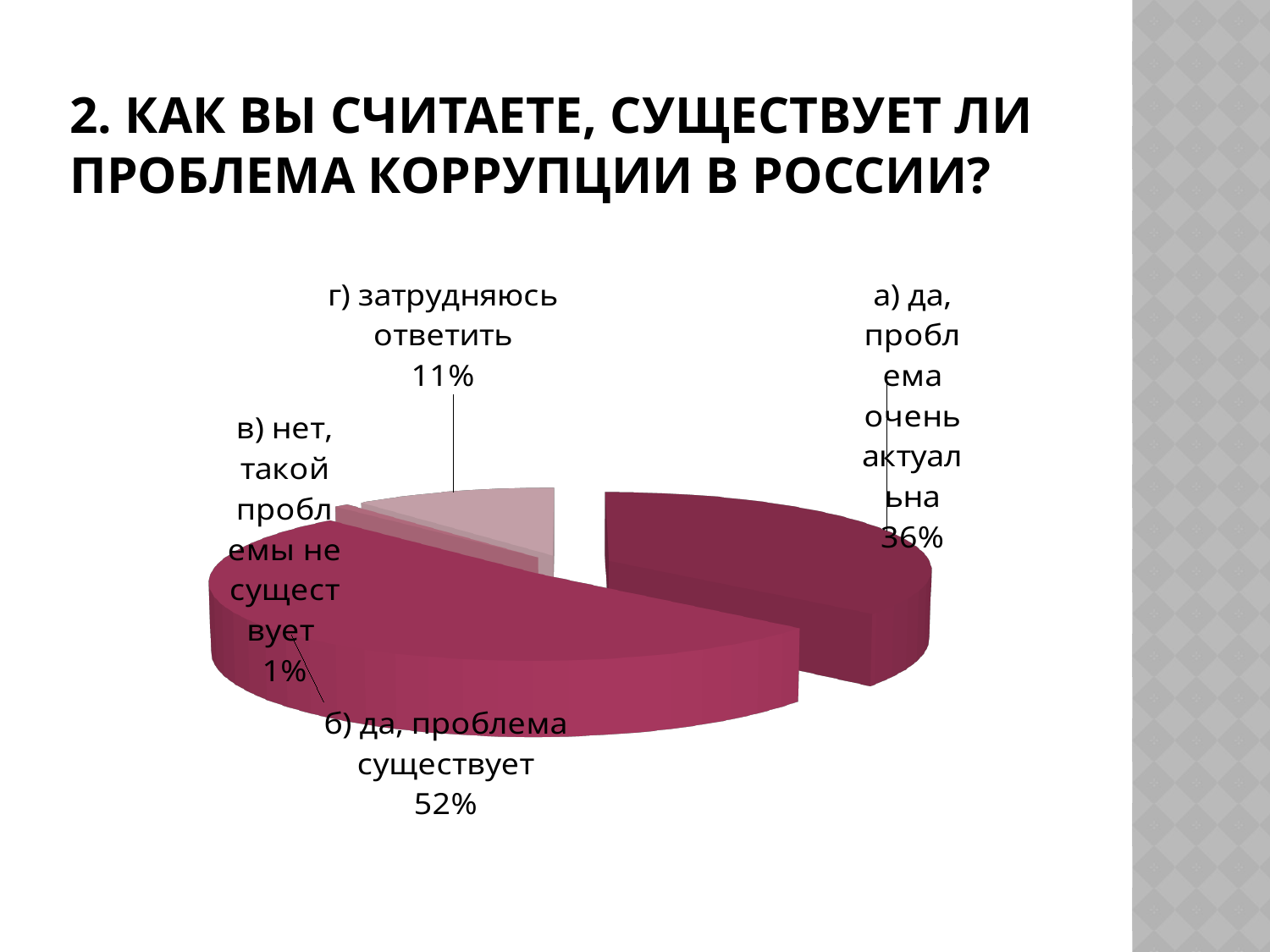
How many slices does the pie chart have? 4 What share of the pie is labelled "г) затрудняюсь ответить"? 11% Which slice of the pie chart is the largest? б) да, проблема существует Which slice of the pie chart is the smallest? в) нет, такой проблемы не существует What is the combined share of the two "да" answers (а and б)? 88% What share of the pie is labelled "а) да, проблема очень актуальна"? 36% What share of the pie is labelled "б) да, проблема существует"? 52% What kind of chart is shown on the slide? pie chart What is the difference in percentage points between "б) да, проблема существует" and "а) да, проблема очень актуальна"? 16% Which is larger: the share for "г) затрудняюсь ответить" or the share for "в) нет, такой проблемы не существует"? г) затрудняюсь ответить What is the title of the slide above the chart? 2. Как вы считаете, существует ли проблема коррупции в России?